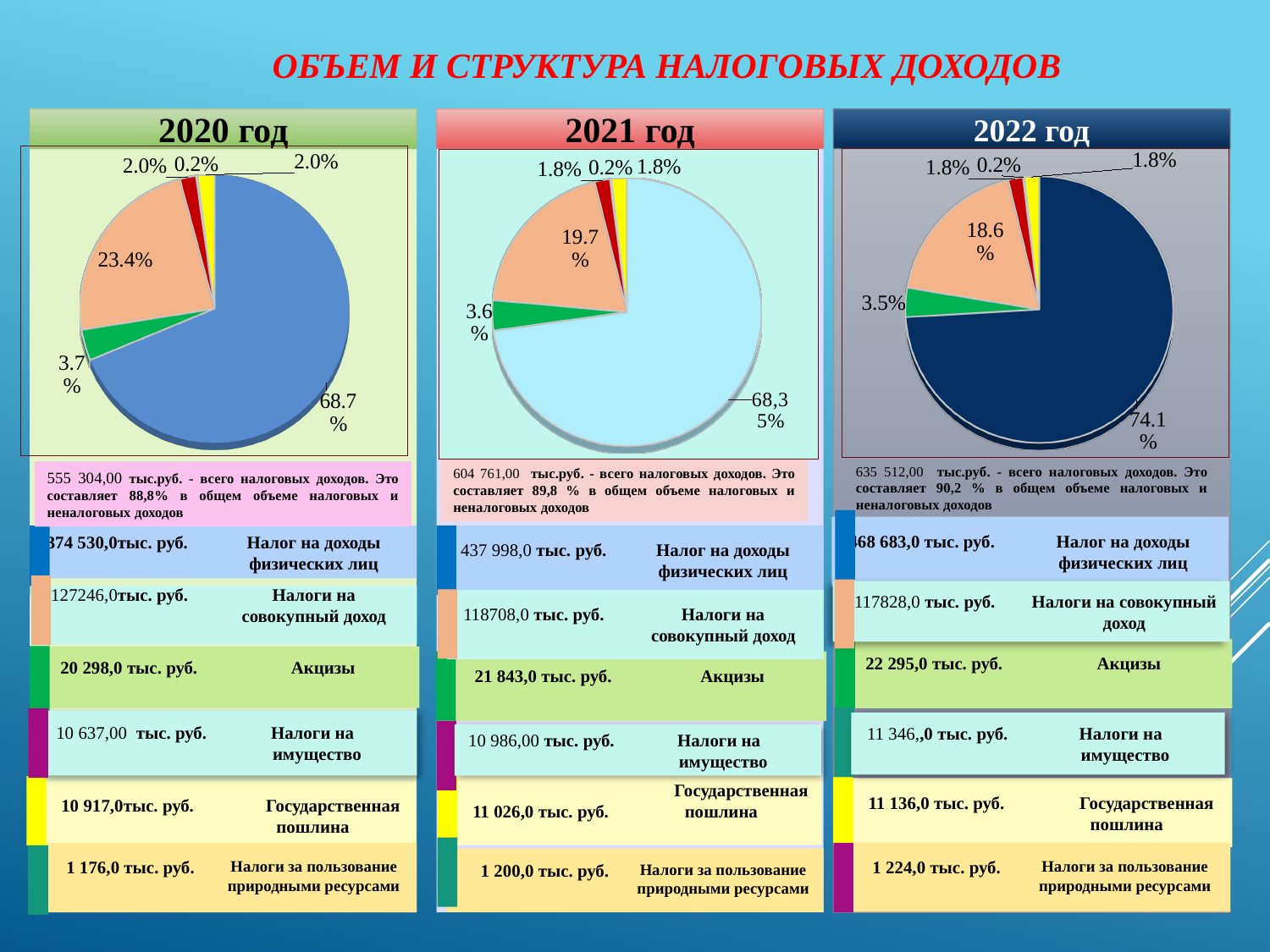
How many slices does the 2022 год pie chart have? 6 What is the title of the slide containing the three pie charts? ОБЪЕМ И СТРУКТУРА НАЛОГОВЫХ ДОХОДОВ In the 2020 год pie chart, what is the share of the smallest slice? 0.2% In the 2022 год pie chart, what share is labelled on the green slice? 3.5% In the 2020 год pie chart, what is the share of the largest slice? 68.7% By how many percentage points does the largest slice of the 2022 год pie chart exceed the largest slice of the 2020 год pie chart? 5.4 In the 2022 год pie chart, what is the share of the largest slice? 74.1% Which is larger: the largest slice of the 2022 год pie chart or the largest slice of the 2020 год pie chart? 2022 год (74.1%) In the 2020 год pie chart, what share is labelled on the orange slice? 23.4% In the 2021 год pie chart, what share is labelled on the orange slice? 19.7% What kind of chart is used for the 2020 год, 2021 год and 2022 год panels? pie chart In the 2021 год pie chart, what is the share of the largest slice? 68,35%